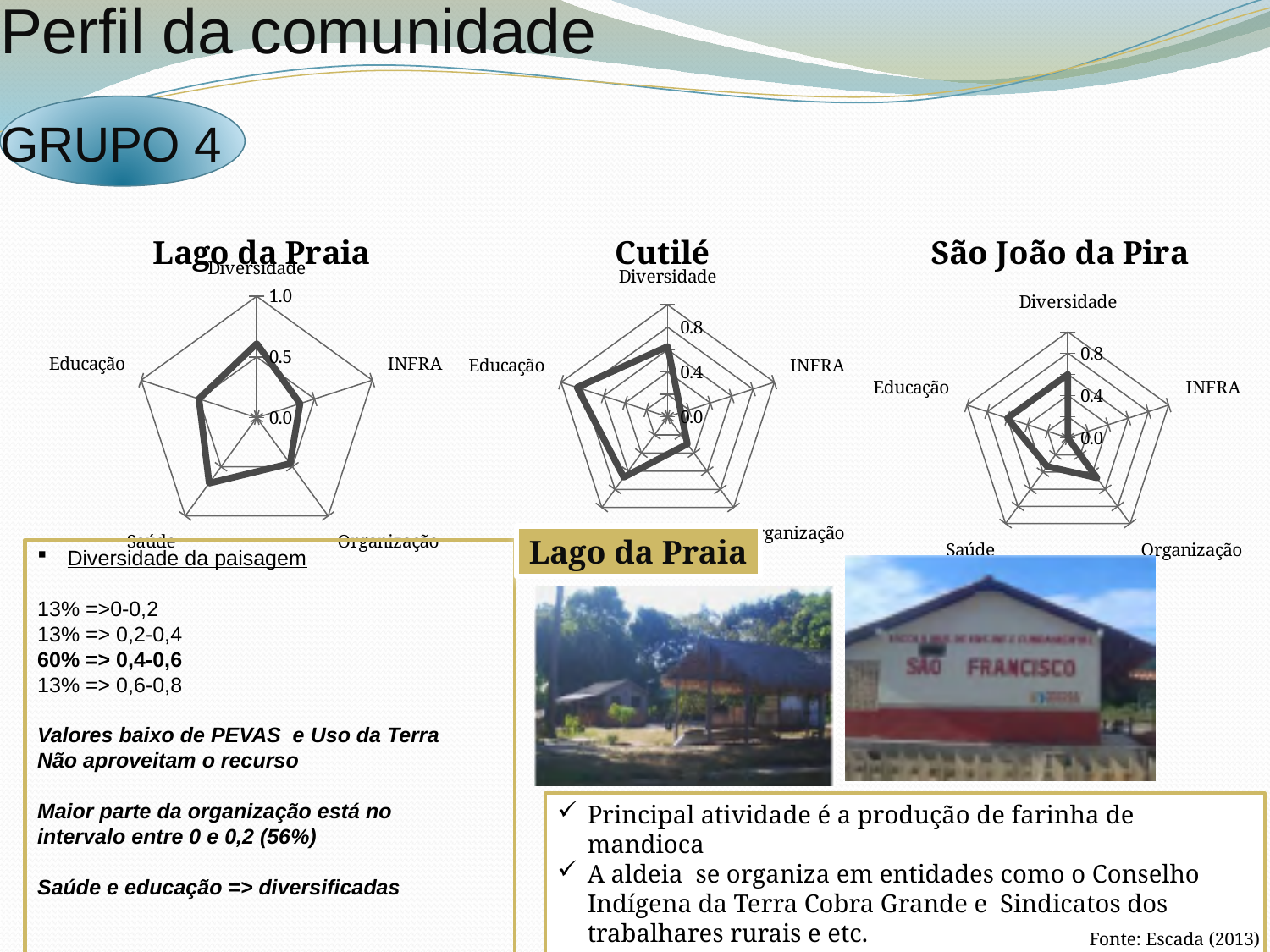
In the Cutilé chart, which is larger, Educação or INFRA? Educação What kind of chart is used for Lago da Praia? radar chart In the Cutilé chart, which category has the lowest value? INFRA In the Cutilé chart, is the value for Educação greater or less than 0.4? greater What is the highest tick value shown on the Lago da Praia chart's axis? 1.0 In the Cutilé chart, is the value for INFRA greater or less than 0.4? less In the Lago da Praia chart, is the value for Saúde greater or less than 0.5? greater In the São João da Pira chart, which category has the lowest value? INFRA How many axes (categories) does the Cutilé radar chart have? 5